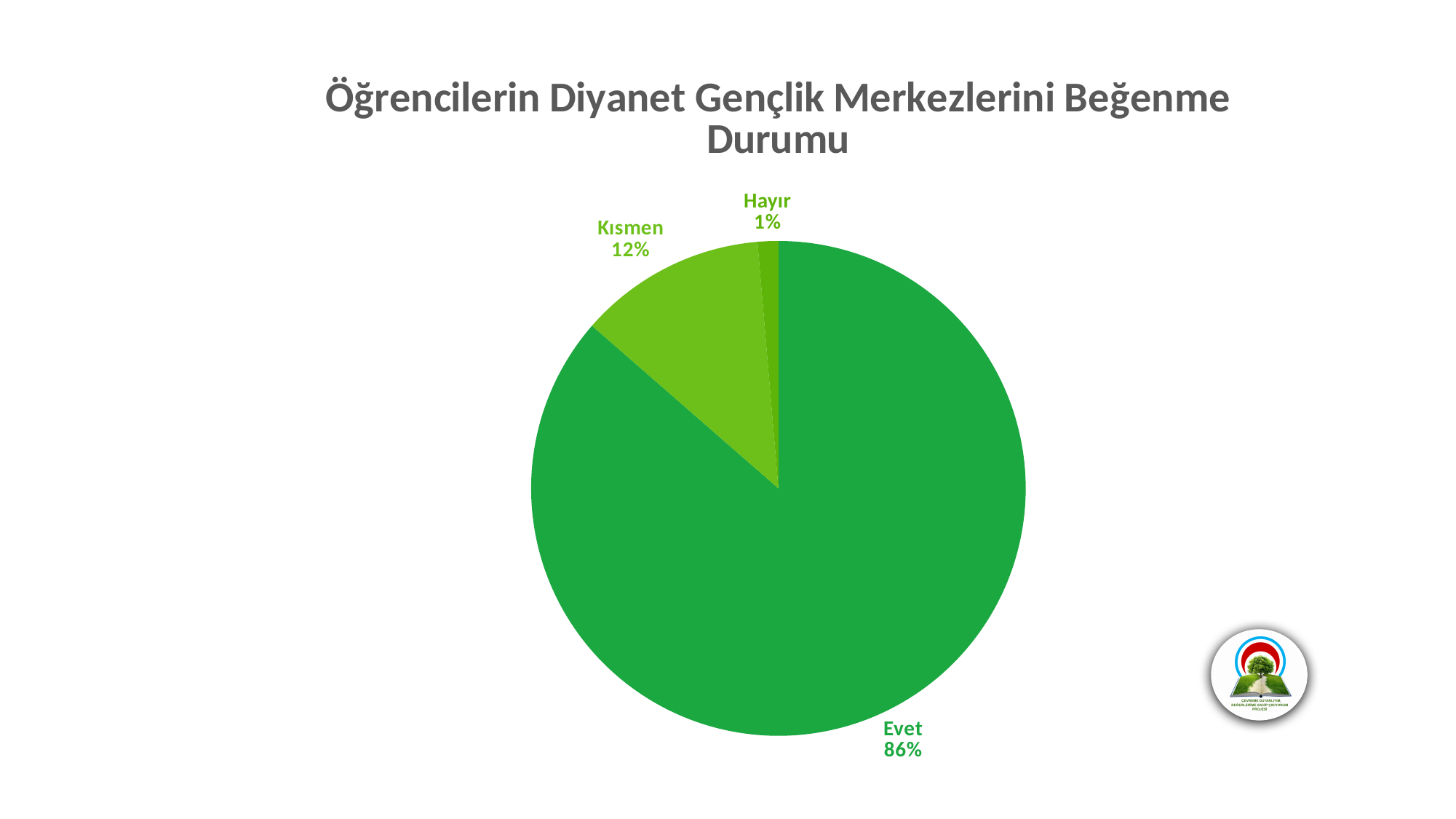
What percentage of students answered "Kısmen"? 12% Which category has the smallest share of the pie? Hayır What kind of chart is shown on the slide? Pie chart What percentage of students answered "Hayır"? 1% What is the difference in percentage points between "Kısmen" and "Hayır"? 11 Which is larger, the share for "Kısmen" or the share for "Hayır"? Kısmen Which category has the largest share of the pie? Evet What is the combined share of "Kısmen" and "Hayır"? 13% What is the difference in percentage points between "Evet" and "Kısmen"? 74 What percentage of students answered "Evet"? 86% How many categories are shown in the pie chart? 3 What is the title of the chart? Öğrencilerin Diyanet Gençlik Merkezlerini Beğenme Durumu